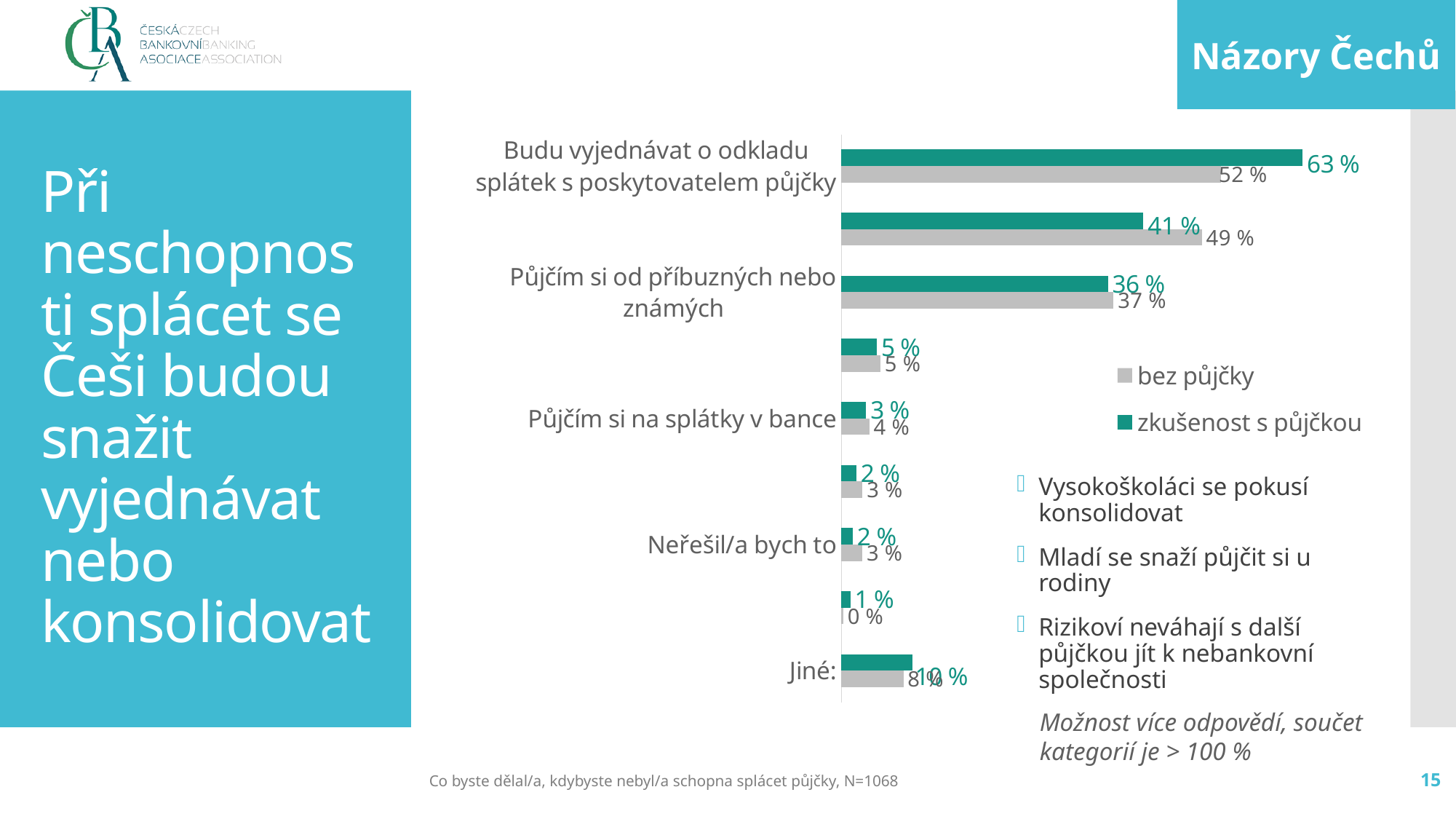
Which category has the highest value for "zkušenost s půjčkou"? Budu vyjednávat o odkladu splátek s poskytovatelem půjčky For "Budu vyjednávat o odkladu splátek s poskytovatelem půjčky", which series has the larger value, "bez půjčky" or "zkušenost s půjčkou"? zkušenost s půjčkou What is the value for "zkušenost s půjčkou" for "Neřešil/a bych to"? 2 % Which series is shown in grey in the chart legend? bez půjčky What is the value for "bez půjčky" for "Půjčím si na splátky v bance"? 4 % What is the value for "zkušenost s půjčkou" for "Půjčím si od příbuzných nebo známých"? 36 % How many series does the chart legend list? 2 What is the value for "bez půjčky" for "Budu vyjednávat o odkladu splátek s poskytovatelem půjčky"? 52 % What is the value for "zkušenost s půjčkou" for "Budu vyjednávat o odkladu splátek s poskytovatelem půjčky"? 63 % For "Budu vyjednávat o odkladu splátek s poskytovatelem půjčky", how much higher is "zkušenost s půjčkou" than "bez půjčky"? 11 percentage points What kind of chart is shown on the slide? Bar chart What is the value for "bez půjčky" for "Půjčím si od příbuzných nebo známých"? 37 %